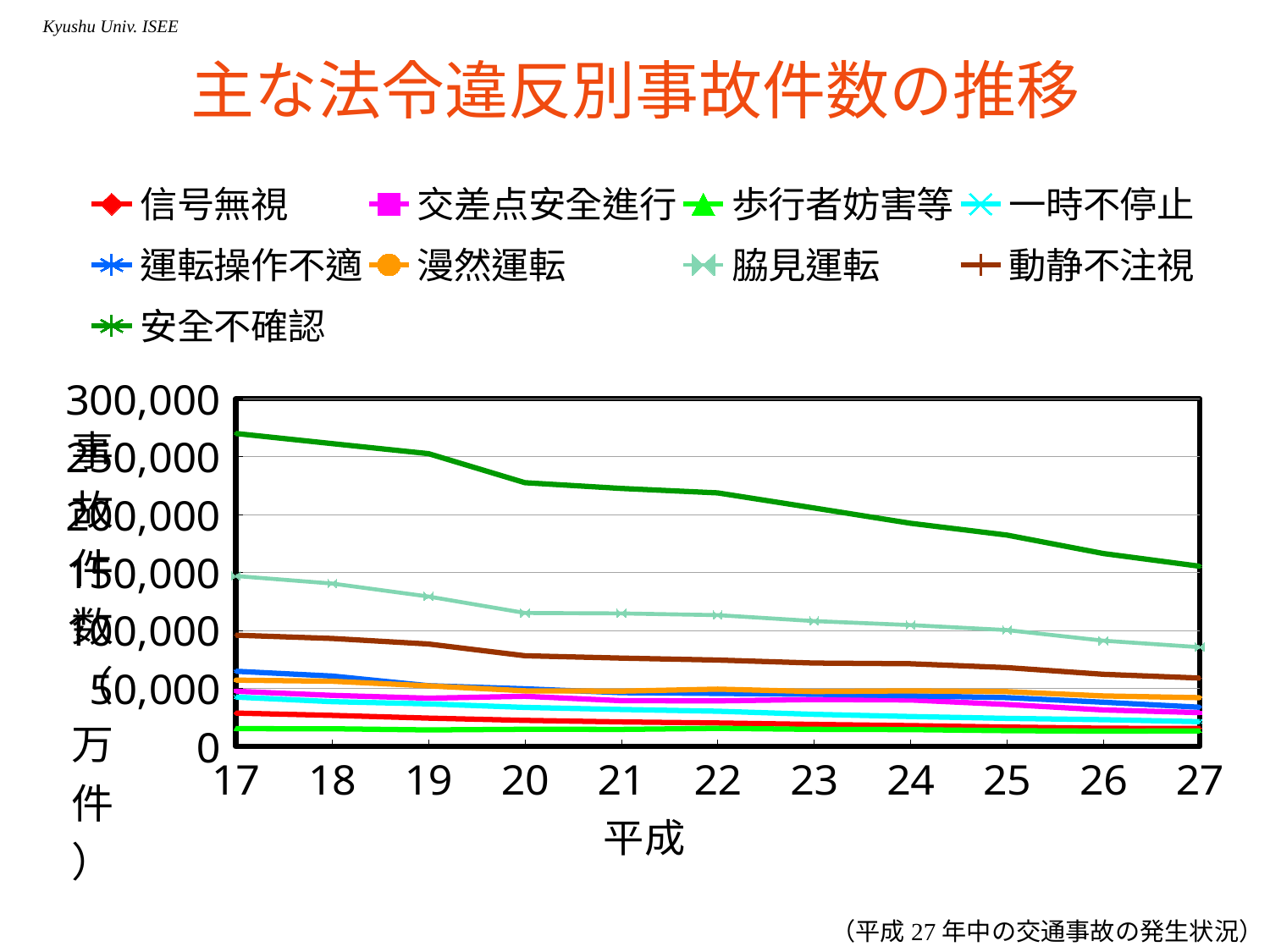
Is the value for 安全不確認 in 平成22 greater or less than 200,000? greater Does the value for 安全不確認 rise or fall from 平成17 to 平成27? fall What is the title of the chart? 主な法令違反別事故件数の推移 How many years (points along the x axis) are plotted? 11 Which series has the lowest values across the chart? 歩行者妨害等 Which series has the highest values across the chart? 安全不確認 Is the value for 安全不確認 in 平成17 greater or less than 250,000? greater How many series does the legend list? 9 What is the label of the x axis? 平成 Is the value for 脇見運転 in 平成27 greater or less than 100,000? less In 平成17, which is larger: 脇見運転 or 動静不注視? 脇見運転 What kind of chart is shown on the slide? line chart